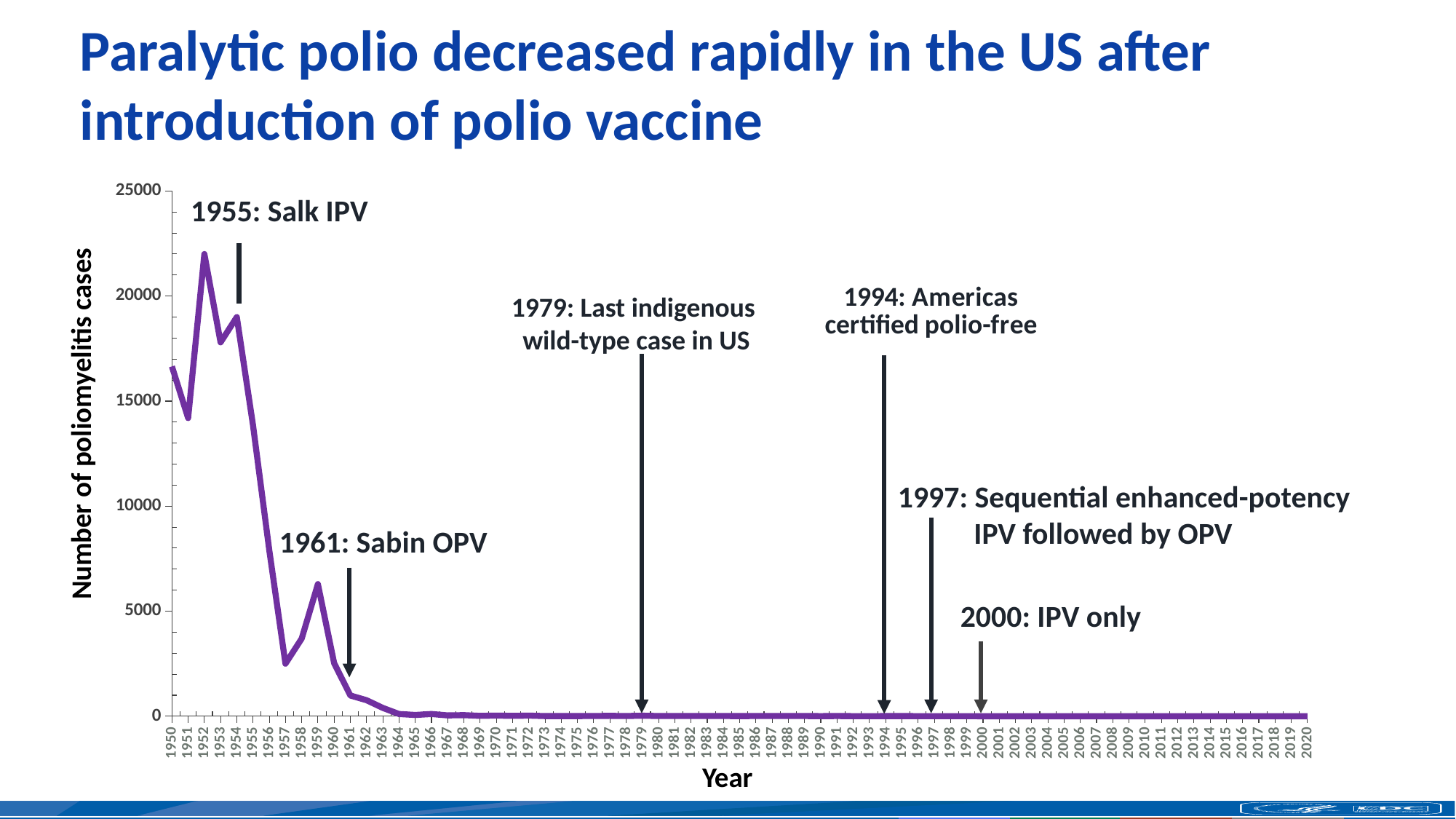
What kind of chart is shown on the slide? line chart Overall, do the number of poliomyelitis cases rise or fall from 1950 to 2020? fall Is the number of poliomyelitis cases in 1959 greater or less than 5000? greater Which year had more poliomyelitis cases, 1952 or 1954? 1952 Is the number of poliomyelitis cases in 1961 greater or less than 5000? less Which year had more poliomyelitis cases, 1959 or 1961? 1959 According to the annotation on the chart, in which year was the Salk IPV introduced? 1955 Which year has the highest number of poliomyelitis cases? 1952 Is the number of poliomyelitis cases in 1957 greater or less than 5000? less What is the label of the y axis? Number of poliomyelitis cases